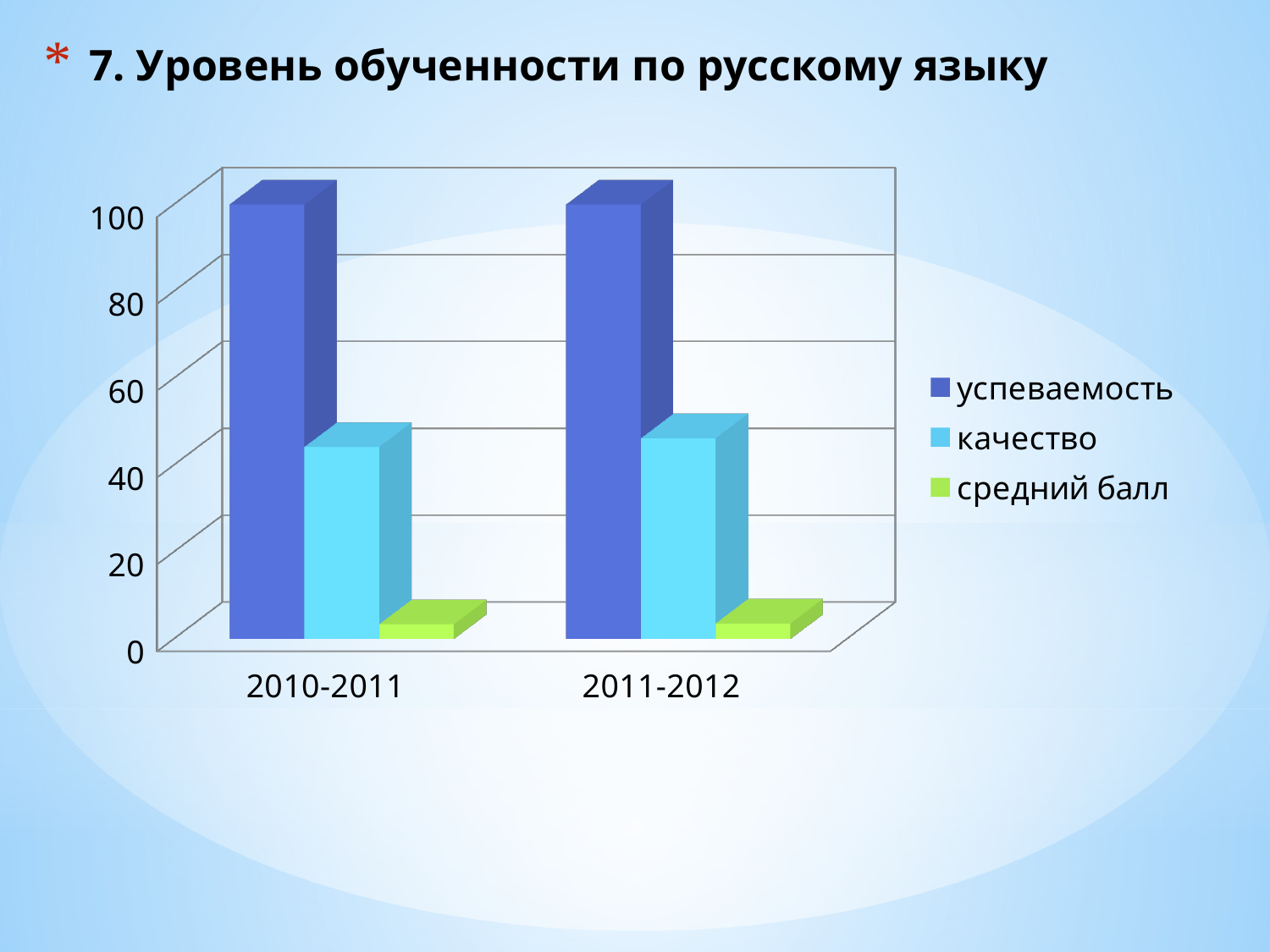
Is the value for успеваемость in 2010-2011 greater or less than 80? greater What kind of chart is shown on the slide? bar chart Is the value for средний балл in 2011-2012 greater or less than 20? less Is the value for качество in 2011-2012 greater or less than 20? greater In 2010-2011, which is larger: успеваемость or качество? успеваемость In 2011-2012, which is larger: качество or средний балл? качество What is the title of the slide containing the chart? 7. Уровень обученности по русскому языку Which series has the highest value in 2011-2012? успеваемость How many categories are shown on the x axis? 2 How many series does the legend list? 3 Which series has the lowest value in 2010-2011? средний балл